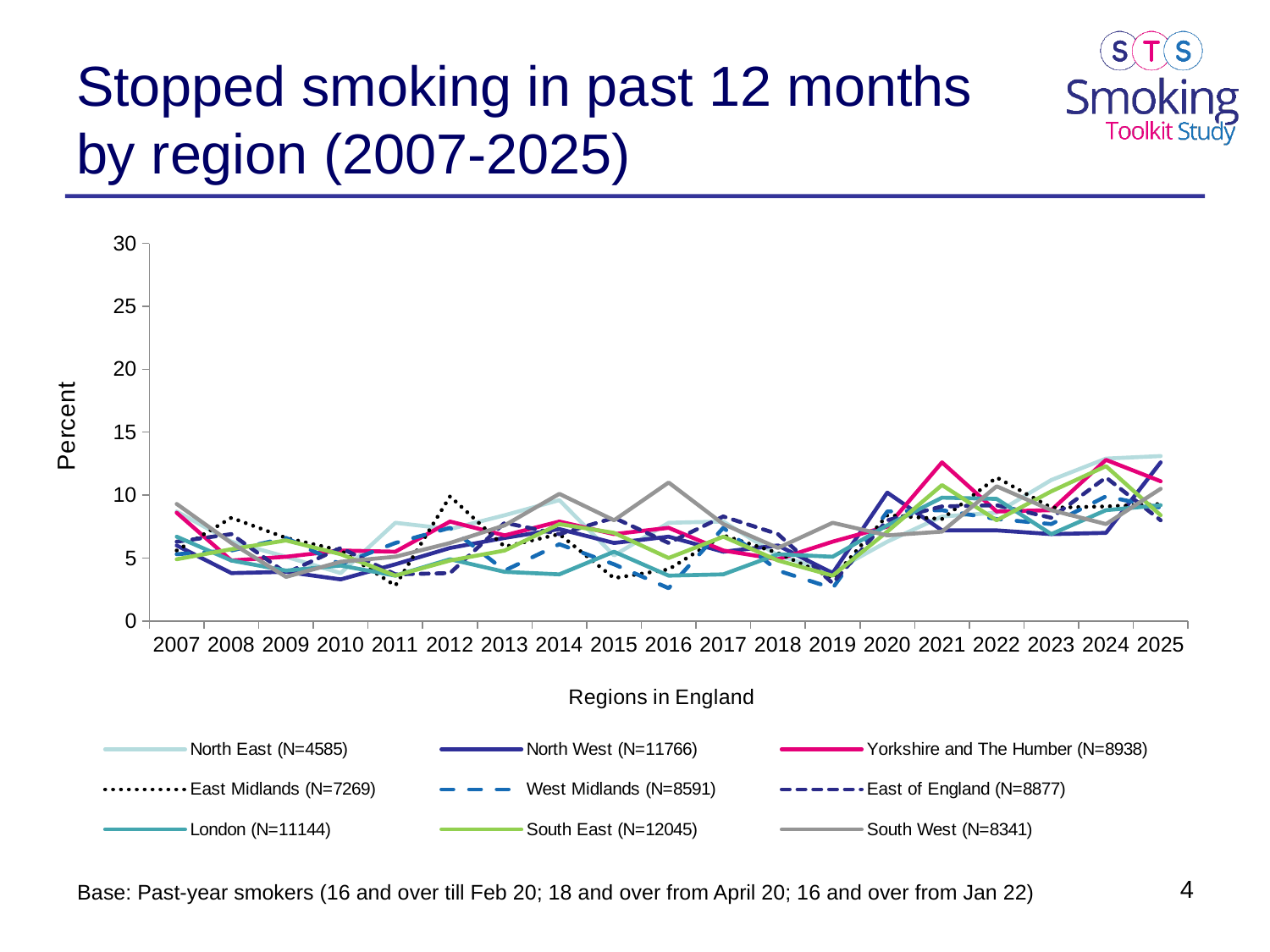
What is the label on the y axis? Percent What type of chart is shown on the slide? line chart Is the value for Yorkshire and The Humber in 2021 greater or less than 10? greater Do the values for North East generally rise or fall from 2019 to 2025? rise Which region has the highest value in 2021? Yorkshire and The Humber Is the value for West Midlands in 2016 greater or less than 5? less How many series does the legend list? 9 Which region has the highest value in 2016? South West In 2016, which is larger: the value for South West or the value for North West? South West Is the value for North East in 2025 greater or less than 10? greater How many years are shown along the x axis? 19